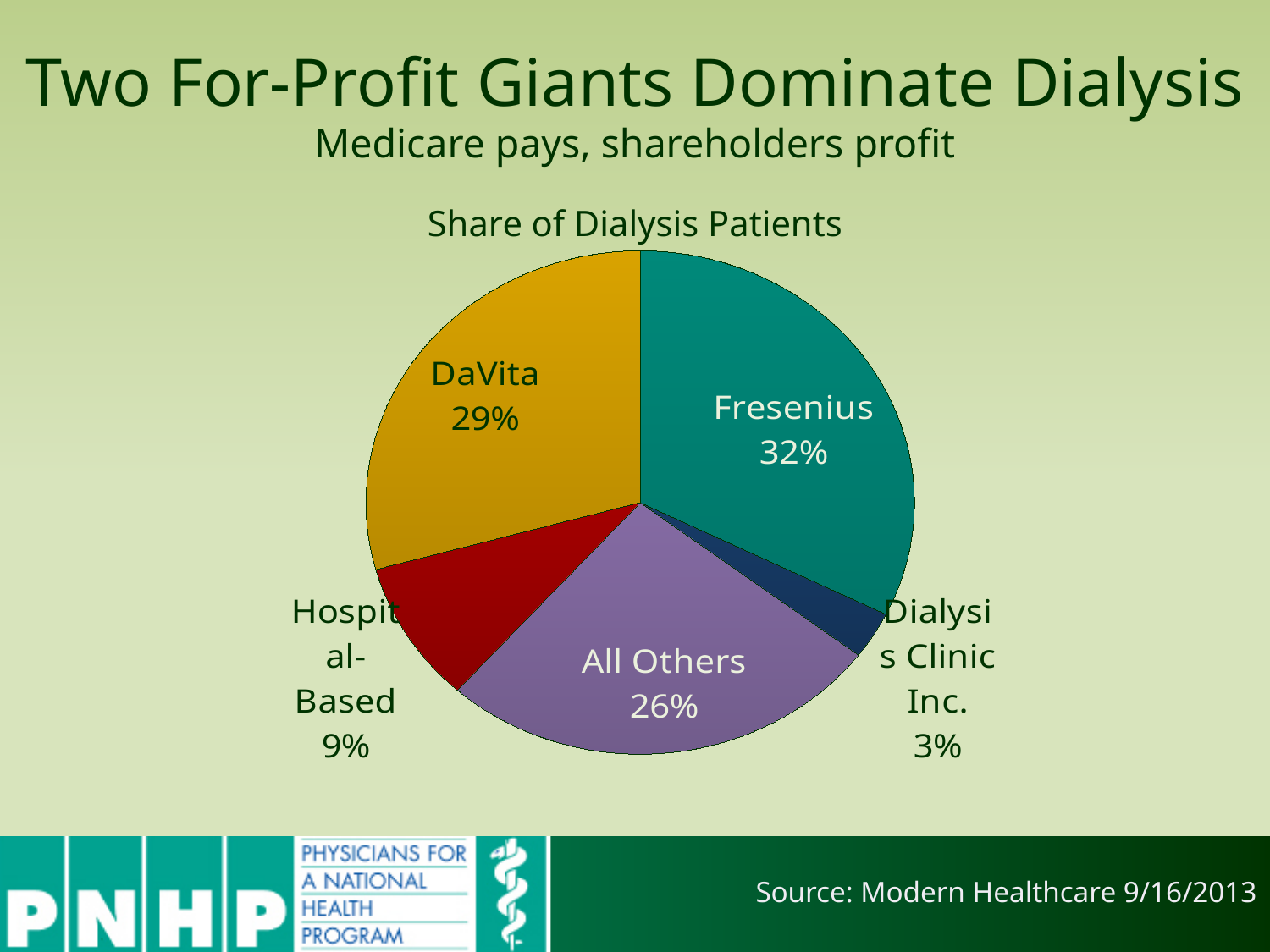
How many slices does the pie chart have? 5 Which slice of the pie is the smallest? Dialysis Clinic Inc. What type of chart is shown on the slide? pie chart Which slice of the pie is the largest? Fresenius Which is larger, the All Others share or the Hospital-Based share? All Others What share of dialysis patients does Dialysis Clinic Inc. have? 3% What is the chart's title? Share of Dialysis Patients What share of dialysis patients does Fresenius have? 32% What is the difference between the Fresenius share and the DaVita share? 3% What share of dialysis patients is Hospital-Based? 9% What share of dialysis patients does DaVita have? 29% What is the combined share of Fresenius and DaVita? 61%